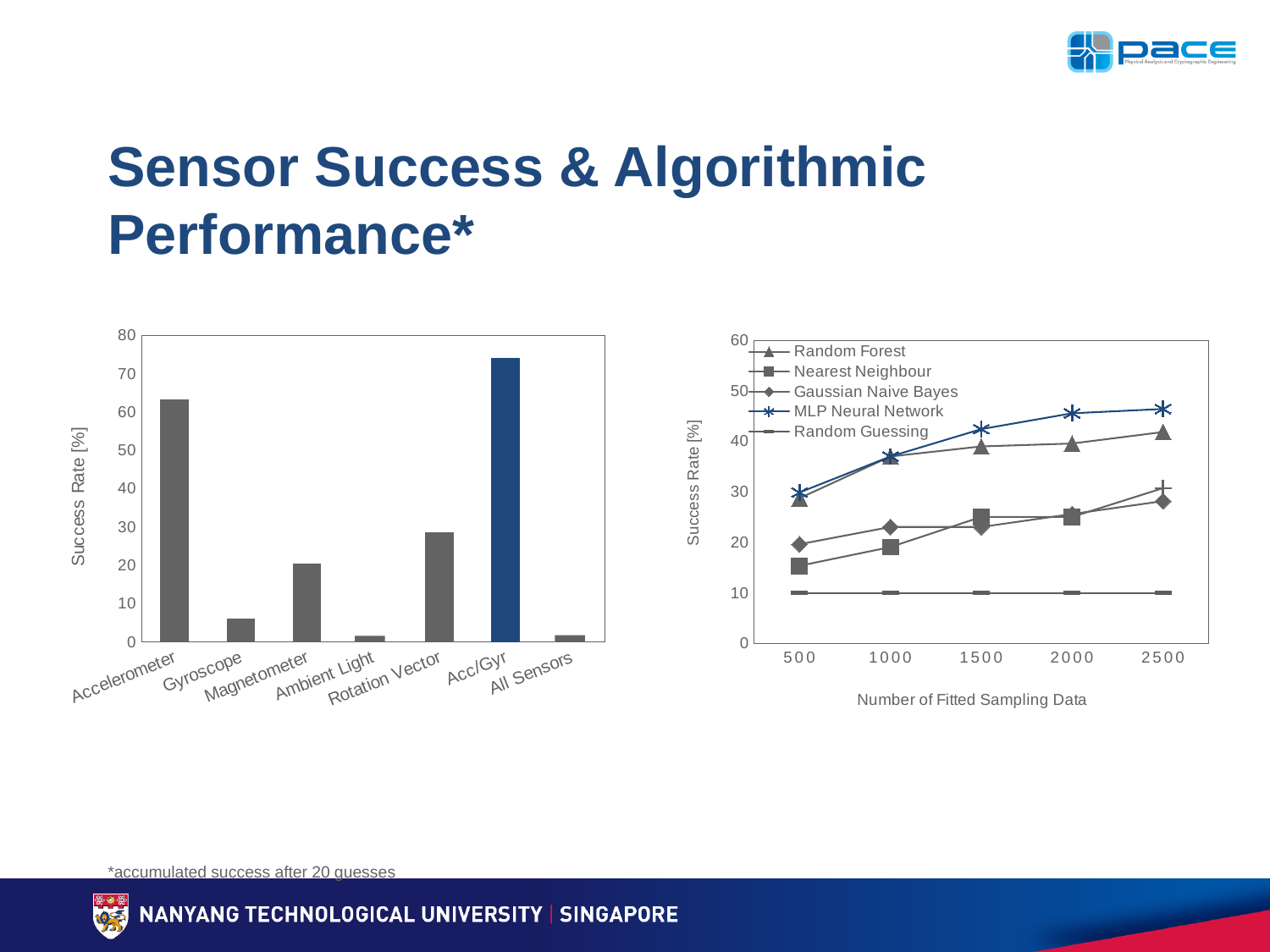
On the left bar chart, how many categories are shown on the x axis? 7 On the right chart, how many series does the legend list? 5 On the left bar chart, is the value for Accelerometer greater or less than 60? greater On the left bar chart, is the value for Gyroscope greater or less than 10? less What kind of chart is the chart on the left? bar chart On the left bar chart, which category has the highest success rate? Acc/Gyr On the left bar chart, which is larger, the value for Magnetometer or the value for Rotation Vector? Rotation Vector On the right chart, what is the label of the x axis? Number of Fitted Sampling Data On the right chart, is the value for MLP Neural Network at 2500 greater or less than 40? greater On the right chart, which series has the lowest success rate at 2500 fitted sampling data? Random Guessing On the right chart, does the Random Forest success rate rise or fall as the number of fitted sampling data increases? rise On the right chart, which series has the highest success rate at 2500 fitted sampling data? MLP Neural Network